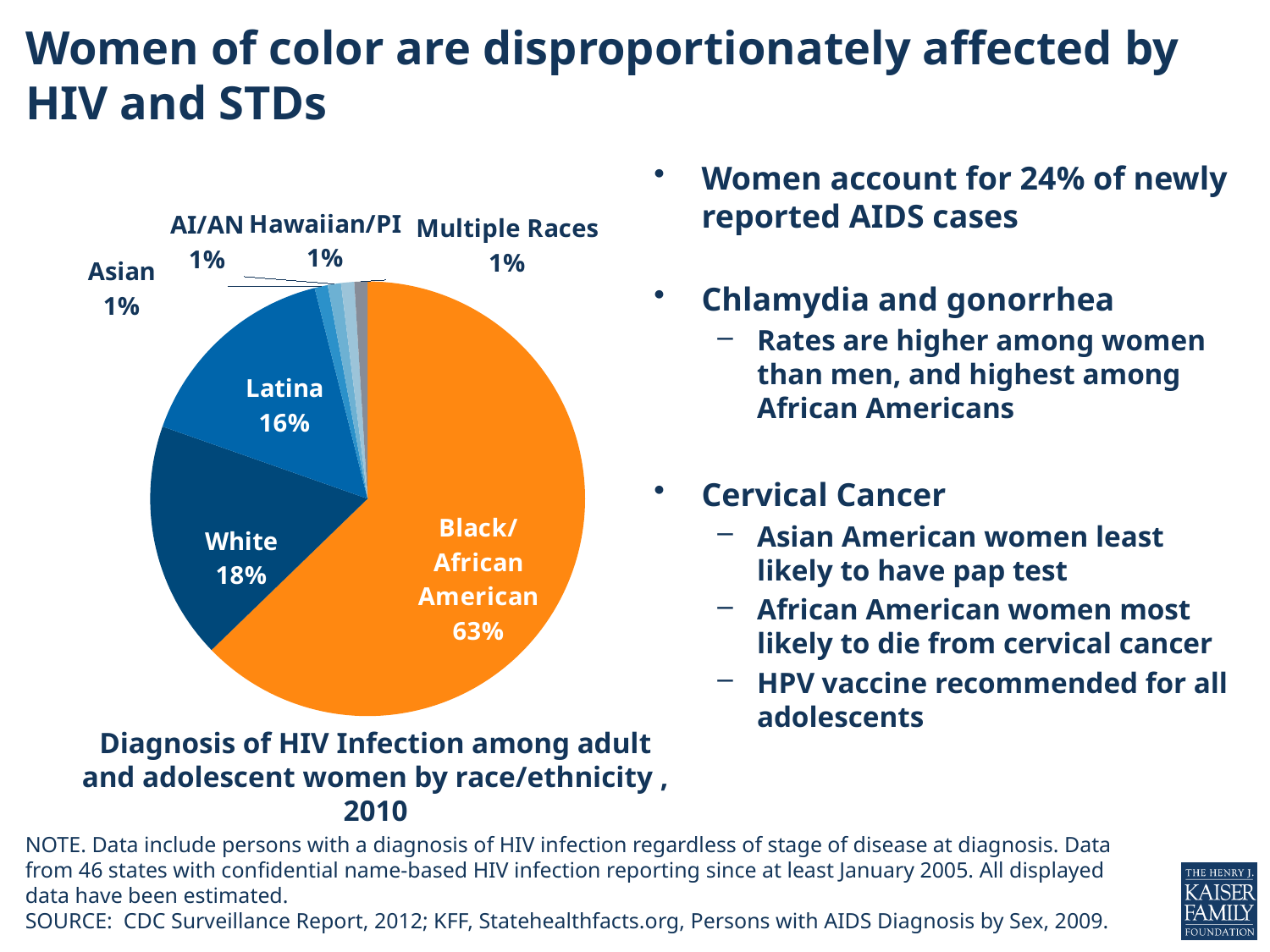
What is the difference in percentage points between the Black/African American slice and the White slice? 45 What is the title of the pie chart? Diagnosis of HIV Infection among adult and adolescent women by race/ethnicity, 2010 Which race/ethnicity group has the largest slice of the pie chart? Black/African American What percentage is shown for Asian women in the pie chart? 1% What share of the pie chart is Latina? 16% What type of chart is used to show HIV diagnoses by race/ethnicity? Pie chart What is the difference in percentage points between the White slice and the Latina slice? 2 What is the combined share of the Latina and White slices in the pie chart? 34% What share of HIV diagnoses among adult and adolescent women in 2010 is Black/African American? 63% How many race/ethnicity categories are shown in the pie chart? 7 What percentage of the pie chart is labeled White? 18% Which is larger in the pie chart, the White slice or the Latina slice? White